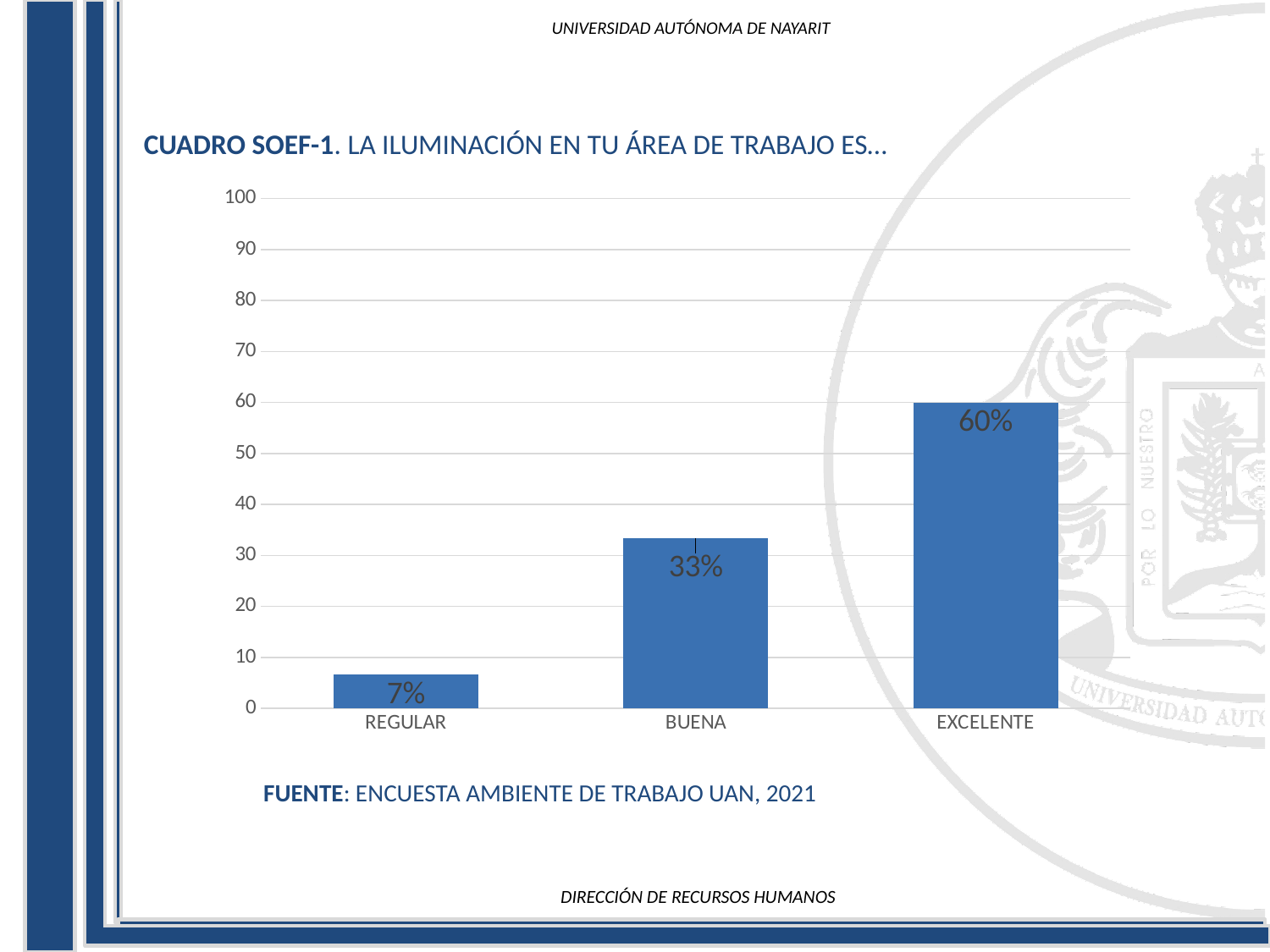
What is the difference between the values for EXCELENTE and BUENA? 27% Which category has the highest value? EXCELENTE What is the value for REGULAR? 7% What kind of chart is shown on the slide? bar chart Do the values rise or fall from REGULAR to EXCELENTE along the x axis? rise Is the value for EXCELENTE greater or less than 50? greater How many categories are shown on the x axis? 3 Which is larger, the value for BUENA or the value for REGULAR? BUENA What is the difference between the values for BUENA and REGULAR? 26% What is the value for EXCELENTE? 60% What is the value for BUENA? 33% Which category has the lowest value? REGULAR